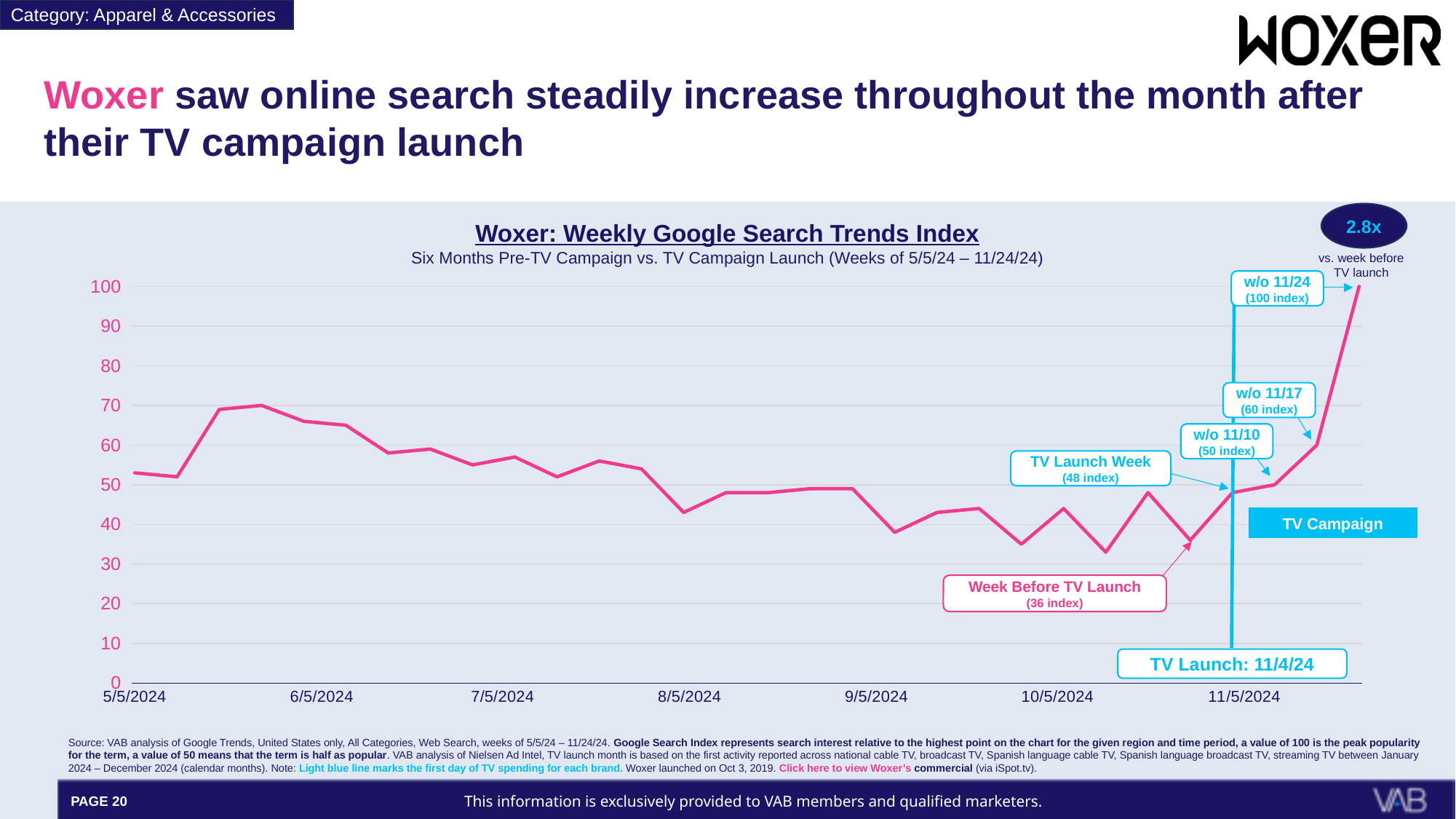
What type of chart is shown on the slide? line chart What is the index value for the TV Launch Week? 48 index What is the title of the chart? Woxer: Weekly Google Search Trends Index What is the index value for the week before the TV launch? 36 index What is the difference between the index for the week of 11/24 and the week before the TV launch? 64 Do the index values rise or fall from the TV Launch Week to the week of 11/24? rise Is the index value for the week of 5/5/2024 greater or less than 60? less What is the index value for the week of 11/10? 50 index What is the index value for the week of 11/24? 100 index Which is larger, the index for the week of 11/17 or the TV Launch Week? w/o 11/17 Which week has the highest index value on the chart? w/o 11/24 What is the index value for the week of 11/17? 60 index